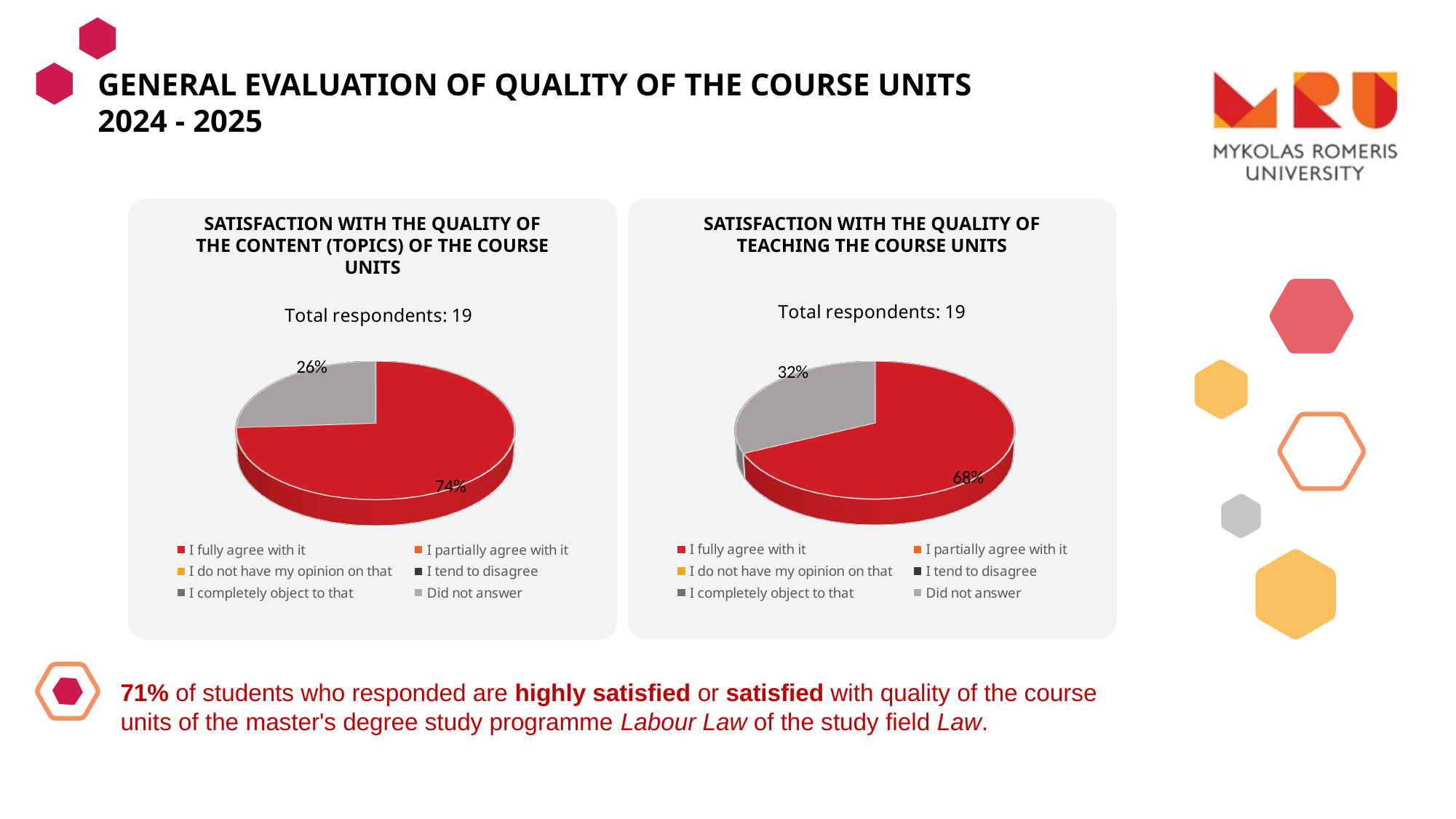
In the chart titled 'Satisfaction with the quality of teaching the course units', what share of respondents is labelled 'Did not answer'? 32% In the chart titled 'Satisfaction with the quality of teaching the course units', which response has the largest slice? I fully agree with it In the chart titled 'Satisfaction with the quality of teaching the course units', what colour is the 'I fully agree with it' slice? Red In the chart titled 'Satisfaction with the quality of the content (topics) of the course units', what is the difference in percentage points between the 'I fully agree with it' slice and the 'Did not answer' slice? 48 In the chart titled 'Satisfaction with the quality of the content (topics) of the course units', what share of respondents is labelled 'Did not answer'? 26% What kind of chart is used in the left-hand chart about satisfaction with the quality of the content of the course units? Pie chart In the chart titled 'Satisfaction with the quality of the content (topics) of the course units', which response has the smallest visible slice? Did not answer Which chart has the larger 'I fully agree with it' slice: the one about the content of the course units or the one about teaching the course units? The one about the content of the course units In the chart titled 'Satisfaction with the quality of the content (topics) of the course units', what share of respondents chose 'I fully agree with it'? 74% How many legend entries are listed under the chart titled 'Satisfaction with the quality of teaching the course units'? 6 How many respondents are reported for the chart titled 'Satisfaction with the quality of the content (topics) of the course units'? 19